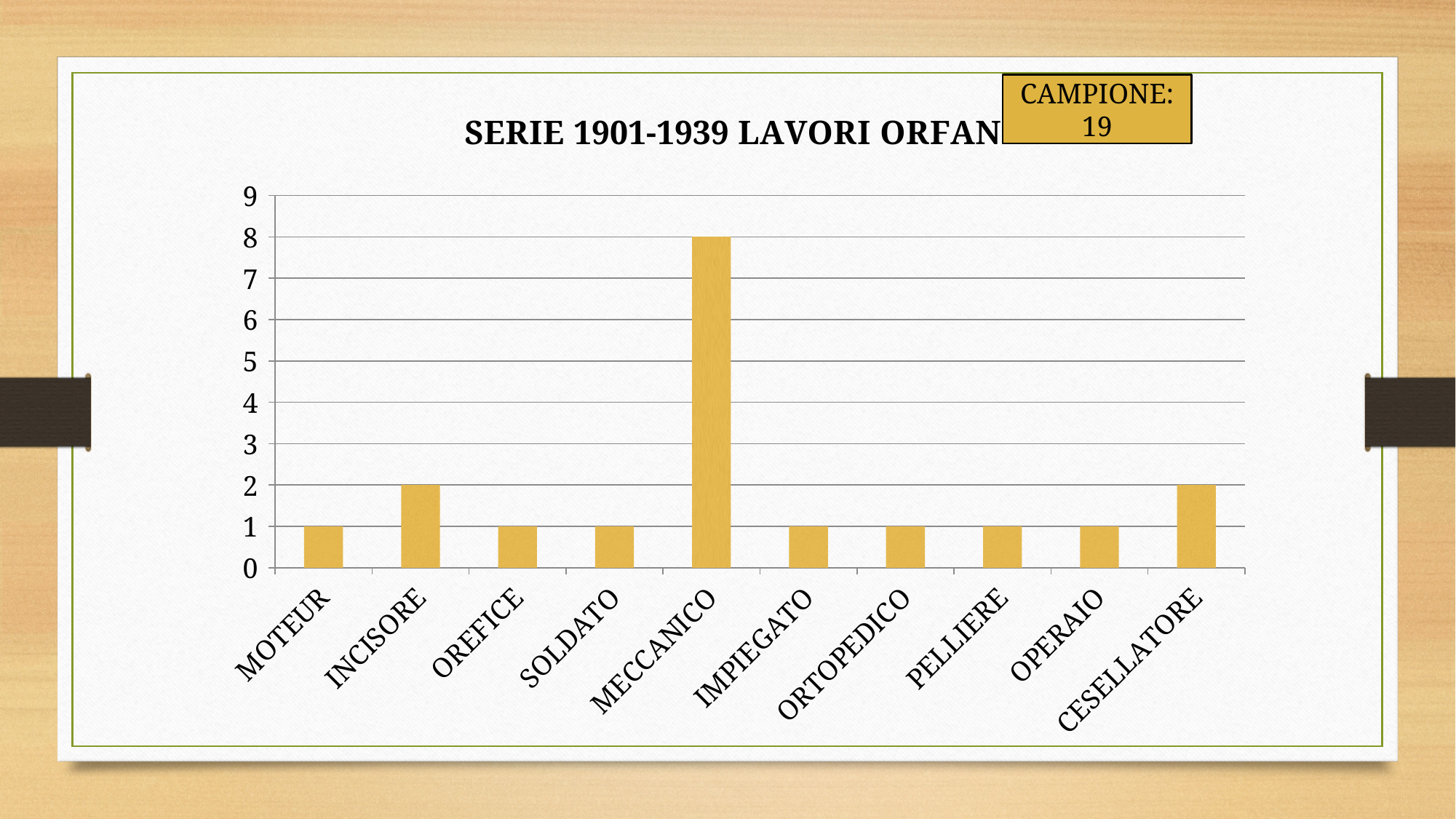
What is the difference between the values for MECCANICO and INCISORE? 6 How many categories are shown on the x axis? 10 What is the value for CESELLATORE? 2 What is the value for INCISORE? 2 Which category has the highest value? MECCANICO Is the value for MECCANICO greater or less than 5? greater What number is shown in the CAMPIONE box at the top right of the slide? 19 What kind of chart is shown on the slide? bar chart What is the value for SOLDATO? 1 Which is larger, the value for INCISORE or the value for OREFICE? INCISORE What is the value for MECCANICO? 8 How many categories have a value of 1? 7